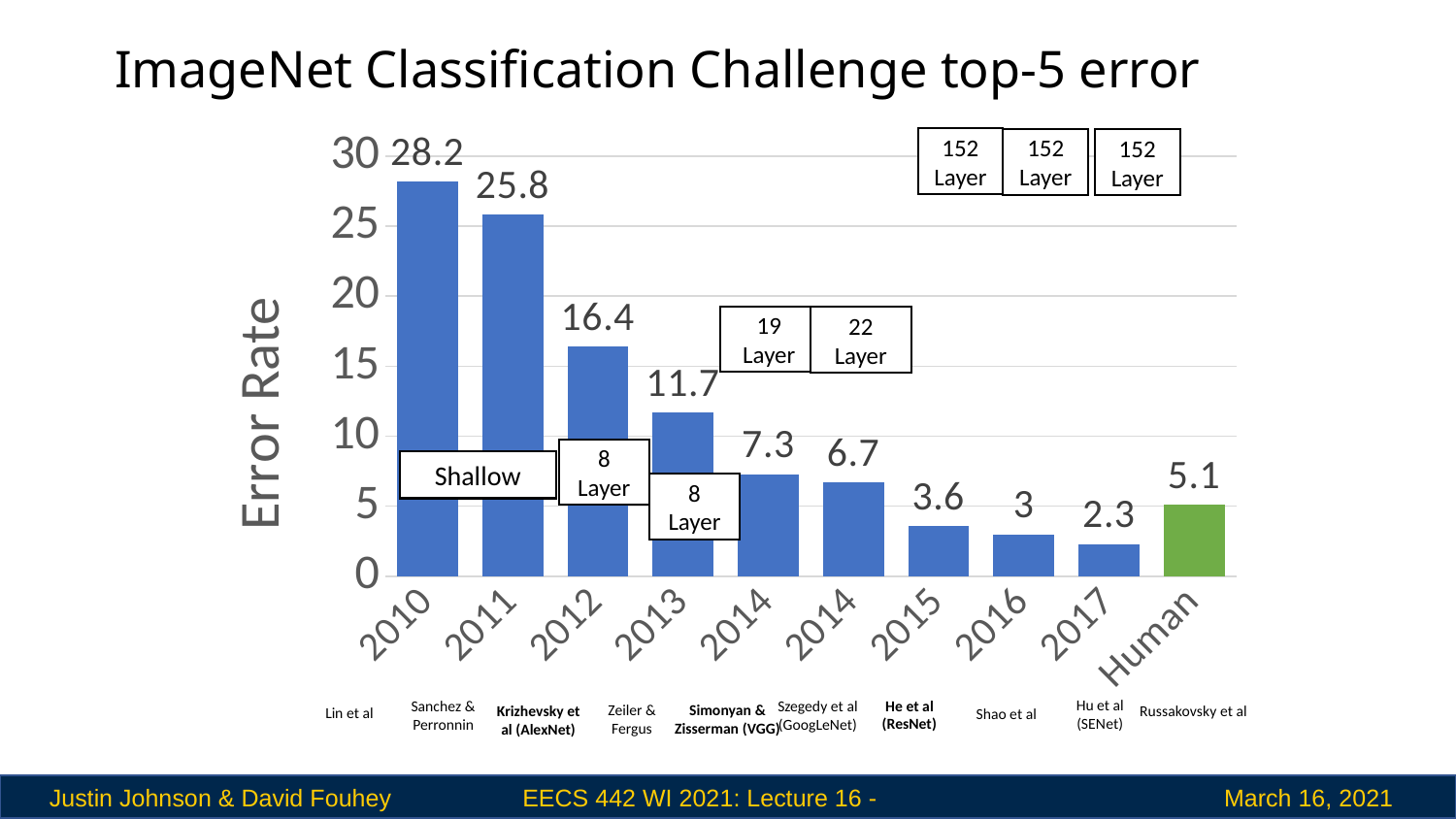
What is the error rate for 2010 (Lin et al)? 28.2 Which bar has the highest error rate? 2010 What is the error rate for the Human bar (Russakovsky et al)? 5.1 What is the error rate for 2012 (Krizhevsky et al, AlexNet)? 16.4 What is the error rate for the 2014 bar labelled Szegedy et al (GoogLeNet)? 6.7 Which bar has the lowest error rate? 2017 What is the error rate for 2017 (Hu et al, SENet)? 2.3 How many bars are shown in the chart? 10 Which has a higher error rate, 2013 (Zeiler & Fergus) or the Human bar? 2013 What type of chart is shown on the slide? Bar chart What is the difference in error rate between 2015 (He et al, ResNet) and the Human bar? 1.5 What is the difference in error rate between 2010 and 2011? 2.4